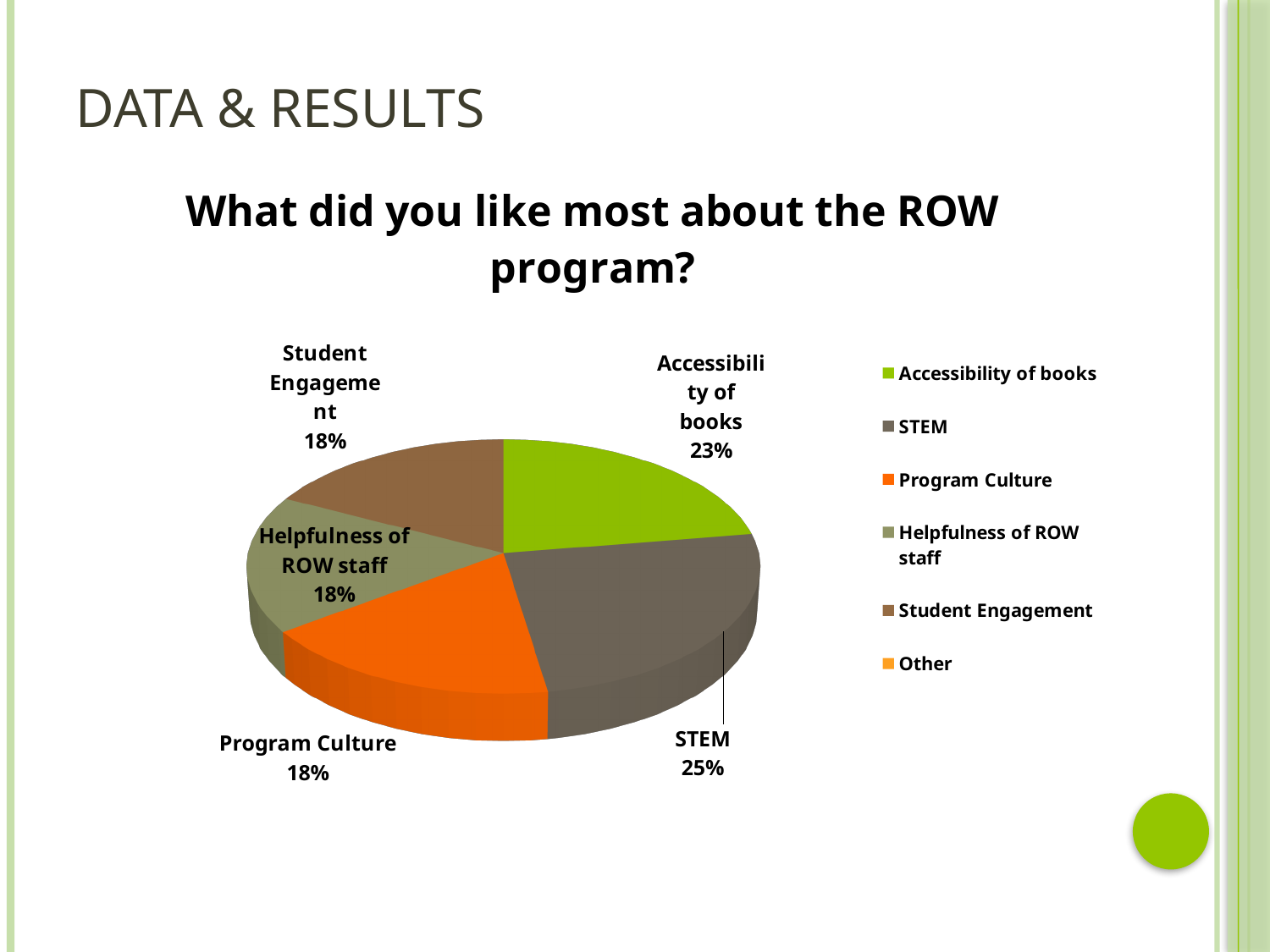
Which is larger, the share for STEM or the share for Student Engagement? STEM How many entries does the legend list? 6 Which category has the largest share of the pie? STEM What is the title of the chart? What did you like most about the ROW program? What percentage of the pie is STEM? 25% What is the difference in percentage points between STEM and Accessibility of books? 2 Which legend entry does not have a visible slice in the pie? Other What percentage of the pie is Accessibility of books? 23% What percentage of the pie is Program Culture? 18% What percentage of the pie is Helpfulness of ROW staff? 18% How many slices of the pie are labelled with a percentage? 5 What kind of chart is shown on the slide? Pie chart